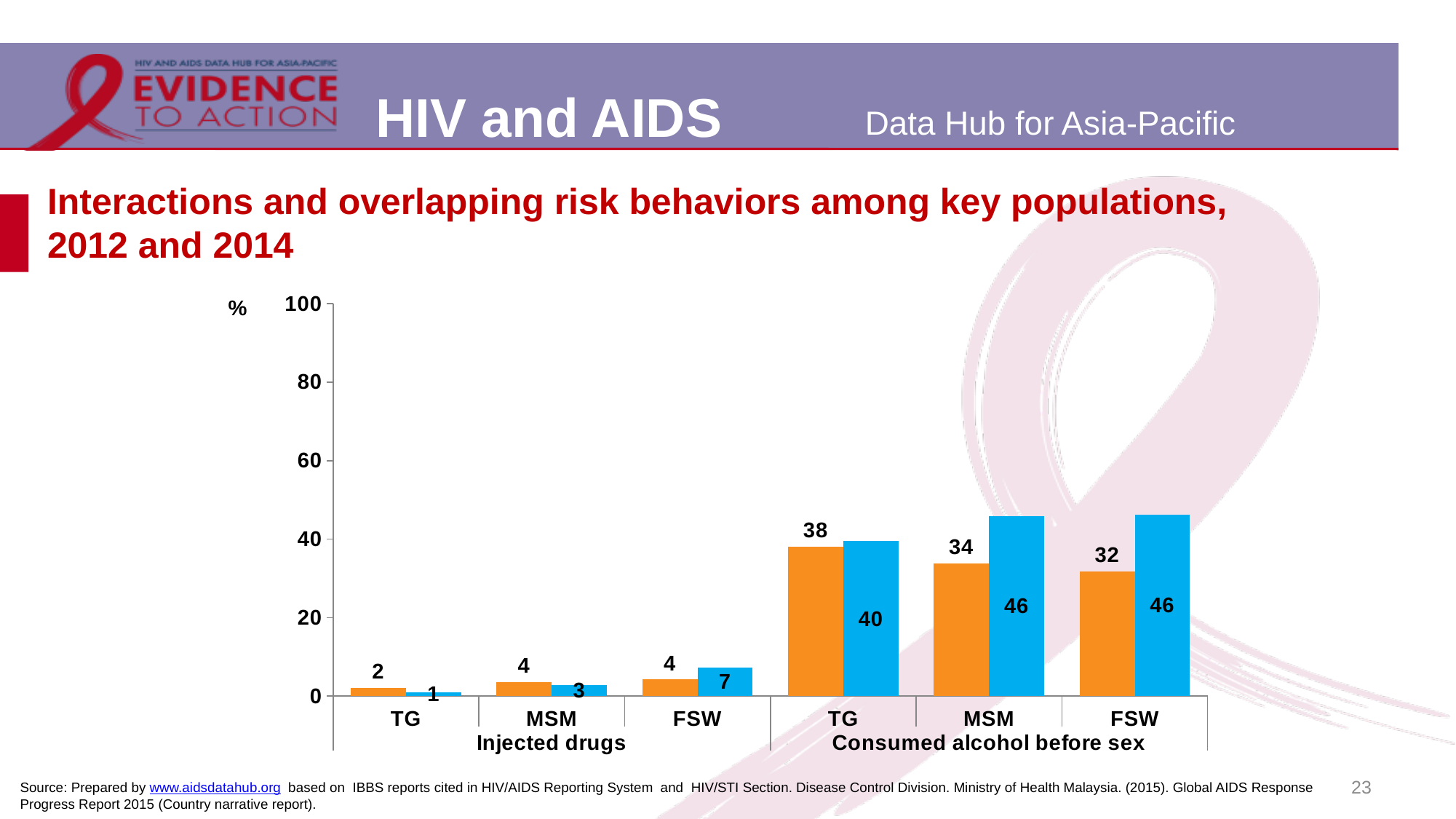
Which category has the lowest blue bar value on the chart? TG (Injected drugs) What is the value of the orange bar for TG under Injected drugs? 2 What is the difference between the blue and orange bars for FSW under Consumed alcohol before sex? 14 Is the value of the blue bar for MSM under Consumed alcohol before sex greater or less than 40? greater What is the difference between the blue and orange bars for MSM under Consumed alcohol before sex? 12 What type of chart is shown on the slide? bar chart How many category labels are shown along the x axis? 6 Which is larger for TG under Injected drugs, the orange bar or the blue bar? orange bar What is the value of the orange bar for MSM under Consumed alcohol before sex? 34 What is the value of the blue bar for TG under Consumed alcohol before sex? 40 What is the value of the blue bar for FSW under Injected drugs? 7 What unit is shown on the vertical axis of the chart? %